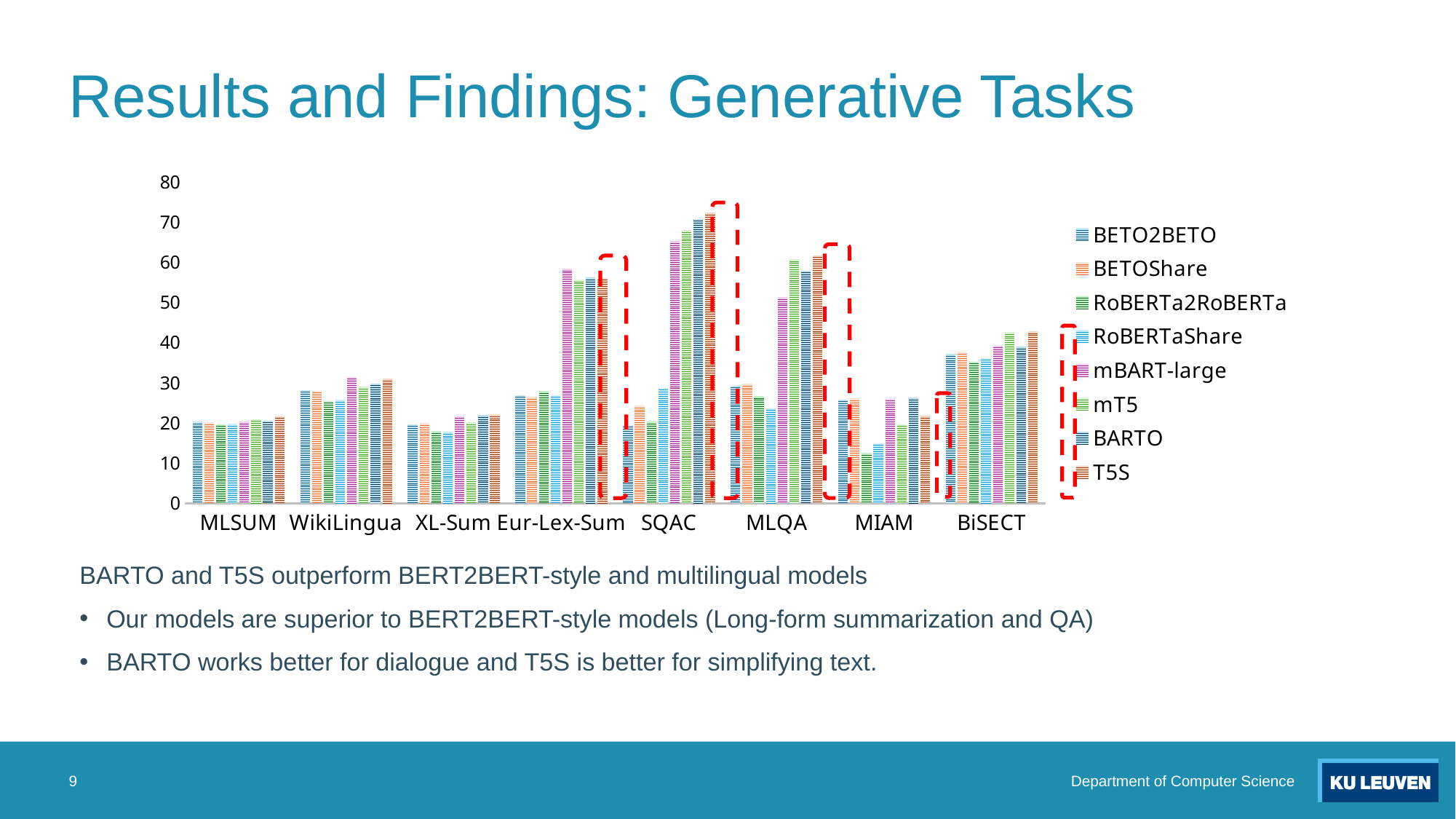
How many series does the legend list? 8 For SQAC, which is larger: mBART-large or BETO2BETO? mBART-large Is the value for RoBERTa2RoBERTa on MIAM greater or less than 20? less Which series has the lowest value for MIAM? RoBERTa2RoBERTa Is the value for mBART-large on Eur-Lex-Sum greater or less than 50? greater Is the value for mT5 on MLQA greater or less than 50? greater For MLQA, which is larger: mT5 or RoBERTaShare? mT5 Which series is listed first in the legend? BETO2BETO What kind of chart is shown on the slide? bar chart How many task categories are shown along the x axis? 8